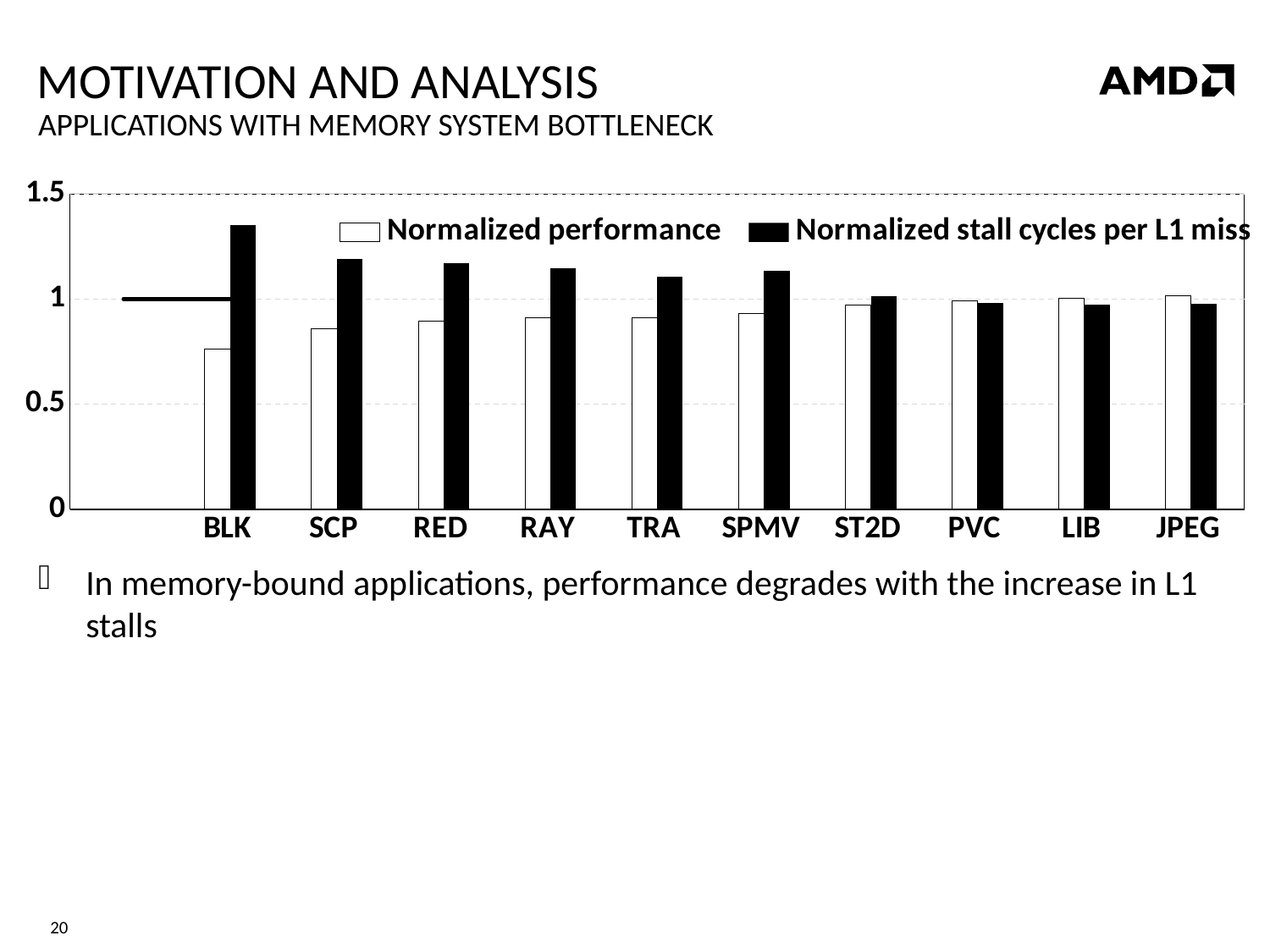
Is the normalized performance for BLK greater or less than 1? less What kind of chart is shown on the slide? bar chart Which series is drawn with black (filled) bars in the chart? Normalized stall cycles per L1 miss How many applications (categories) are shown on the x axis of the chart? 10 Is the normalized stall cycles per L1 miss value for SCP greater or less than 1? greater Is the normalized stall cycles per L1 miss value for BLK greater or less than 1? greater Which application has the lowest normalized performance? BLK Does normalized performance generally rise or fall moving from BLK to JPEG along the x axis? rise For BLK, which is larger: normalized performance or normalized stall cycles per L1 miss? Normalized stall cycles per L1 miss Which application has the highest normalized stall cycles per L1 miss? BLK How many series does the chart's legend list? 2